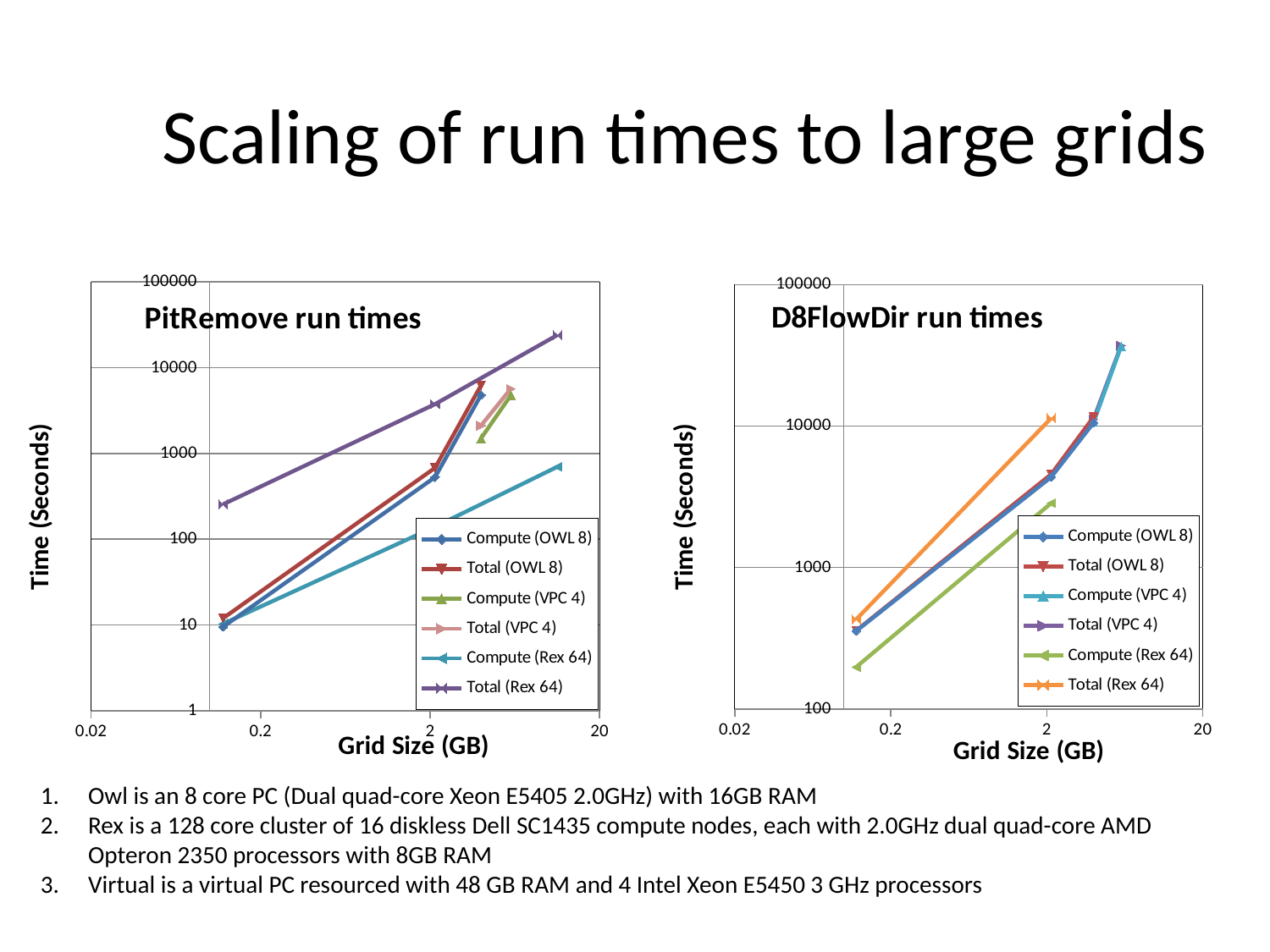
In the D8FlowDir run times chart, is the largest-grid value for Total (VPC 4) greater or less than 10000 seconds? greater What is the label on the horizontal axis of the PitRemove run times chart? Grid Size (GB) In the PitRemove run times chart, do run times rise or fall as grid size increases? rise What is the label on the vertical axis of the D8FlowDir run times chart? Time (Seconds) In the D8FlowDir run times chart, is the smallest-grid value for Compute (Rex 64) greater or less than 1000 seconds? less In the PitRemove run times chart, is the largest-grid value for Total (Rex 64) greater or less than 10000 seconds? greater How many series does the legend of the D8FlowDir run times chart list? 6 In the D8FlowDir run times chart, do run times rise or fall as grid size increases? rise What kind of chart is the PitRemove run times chart? line chart In the PitRemove run times chart, at the largest grid size, which is larger: Total (Rex 64) or Compute (Rex 64)? Total (Rex 64) How many series does the legend of the PitRemove run times chart list? 6